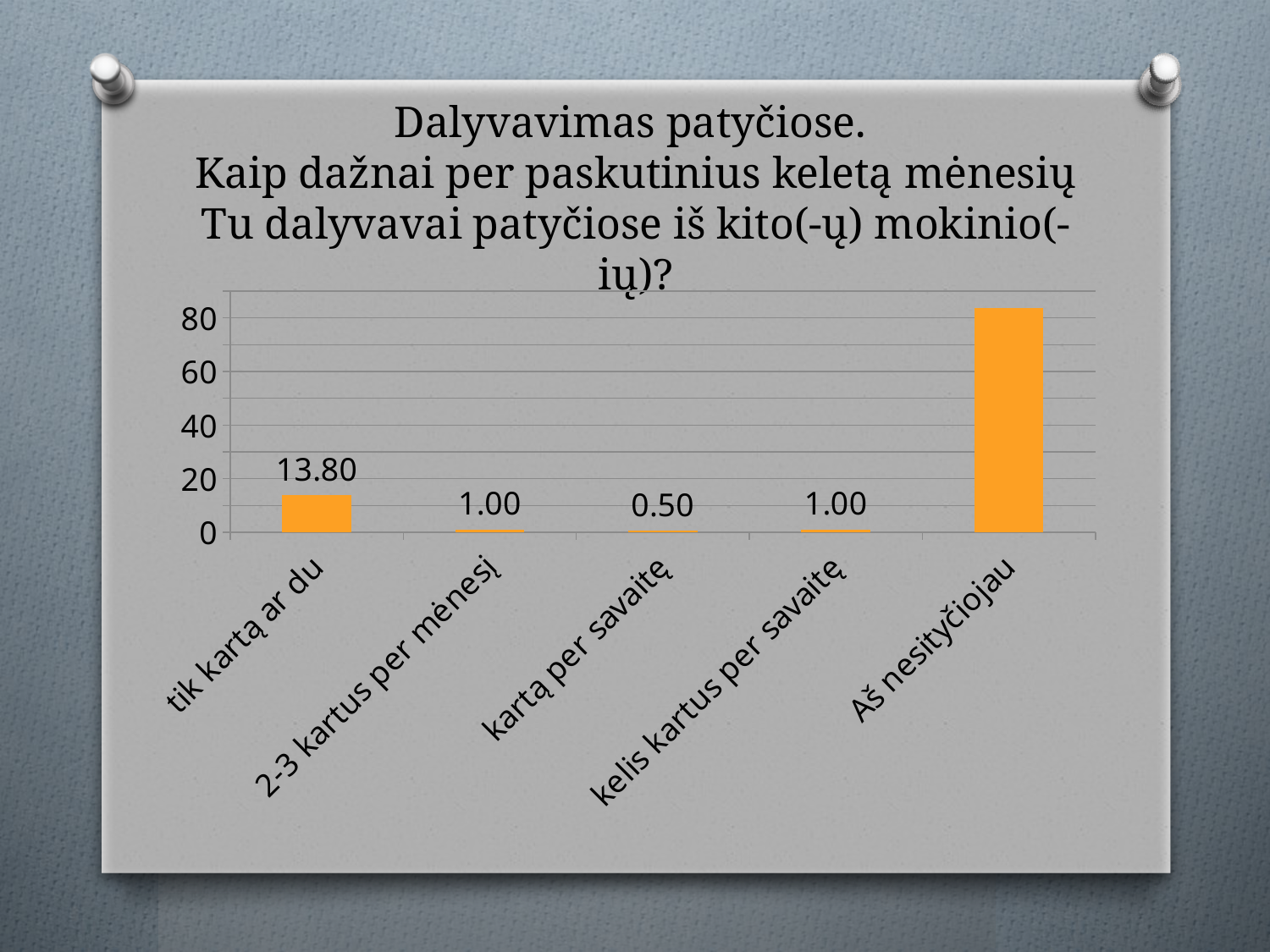
Which category has the lowest value? kartą per savaitę What is the value for "tik kartą ar du"? 13.80 What kind of chart is shown on the slide? bar chart Is the value for "Aš nesityčiojau" greater or less than 60? greater Which category has the highest value? Aš nesityčiojau What is the value for "kelis kartus per savaitę"? 1.00 What is the value for "kartą per savaitę"? 0.50 Which is larger, the value for "tik kartą ar du" or the value for "kelis kartus per savaitę"? tik kartą ar du What colour are the bars in the chart? orange How many categories are shown on the x axis? 5 What is the difference between the values for "tik kartą ar du" and "kartą per savaitę"? 13.30 What is the value for "2-3 kartus per mėnesį"? 1.00